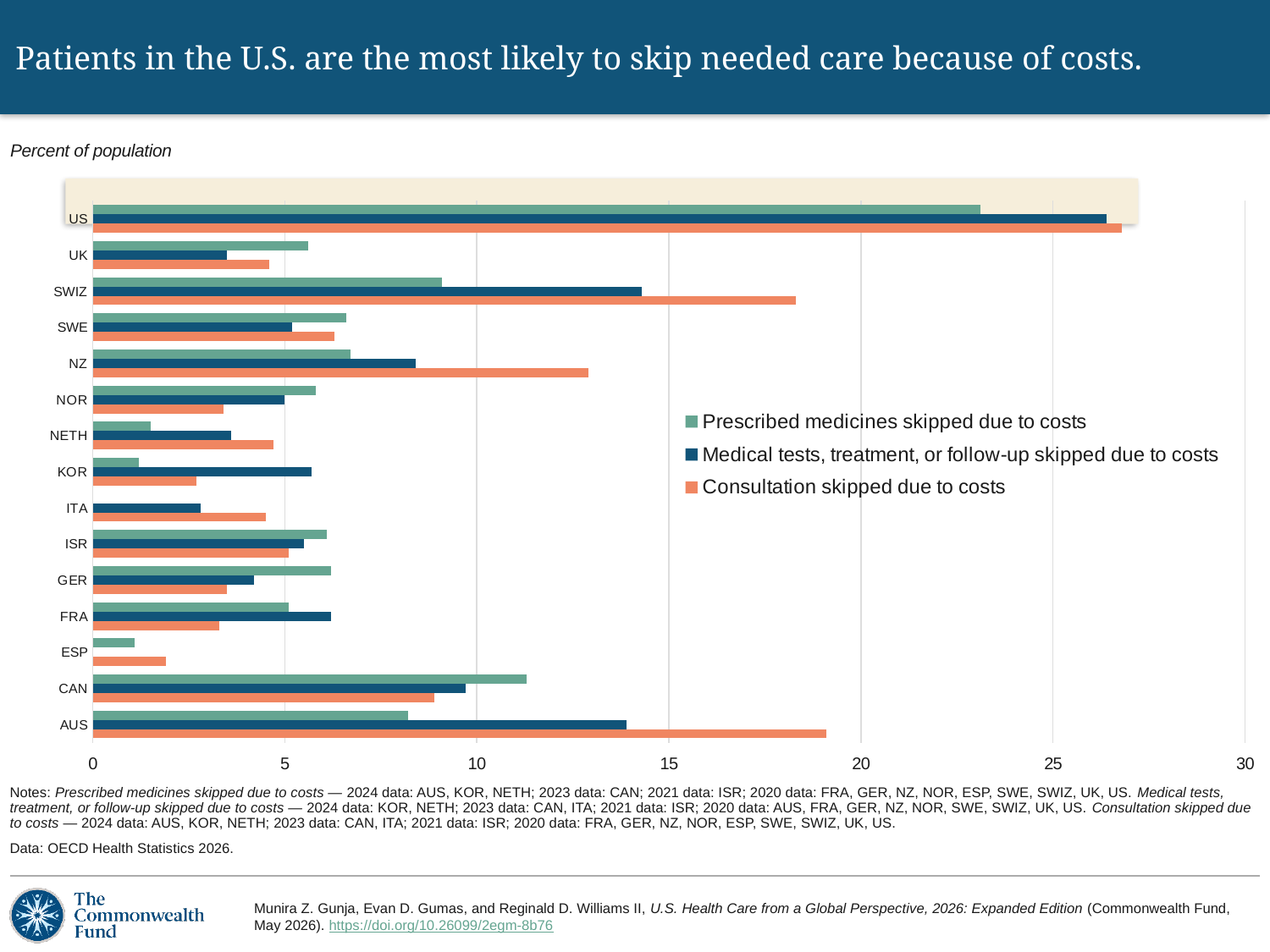
Which country has the highest value for medical tests, treatment, or follow-up skipped due to costs? US Which country has the highest value for consultation skipped due to costs? US What kind of chart is shown on the slide? Bar chart Is the value for prescribed medicines skipped due to costs in the US greater or less than 20? greater Which is larger, the consultation skipped due to costs value for AUS or for CAN? AUS Which country has the lowest value for consultation skipped due to costs? ESP What colour represents consultation skipped due to costs in the legend? Orange Is the value for consultation skipped due to costs in SWIZ greater or less than 15? greater Is the value for consultation skipped due to costs in NZ greater or less than 10? greater How many series does the legend list? 3 For KOR, which is larger: prescribed medicines skipped due to costs or medical tests, treatment, or follow-up skipped due to costs? Medical tests, treatment, or follow-up skipped due to costs How many countries are shown on the chart? 15